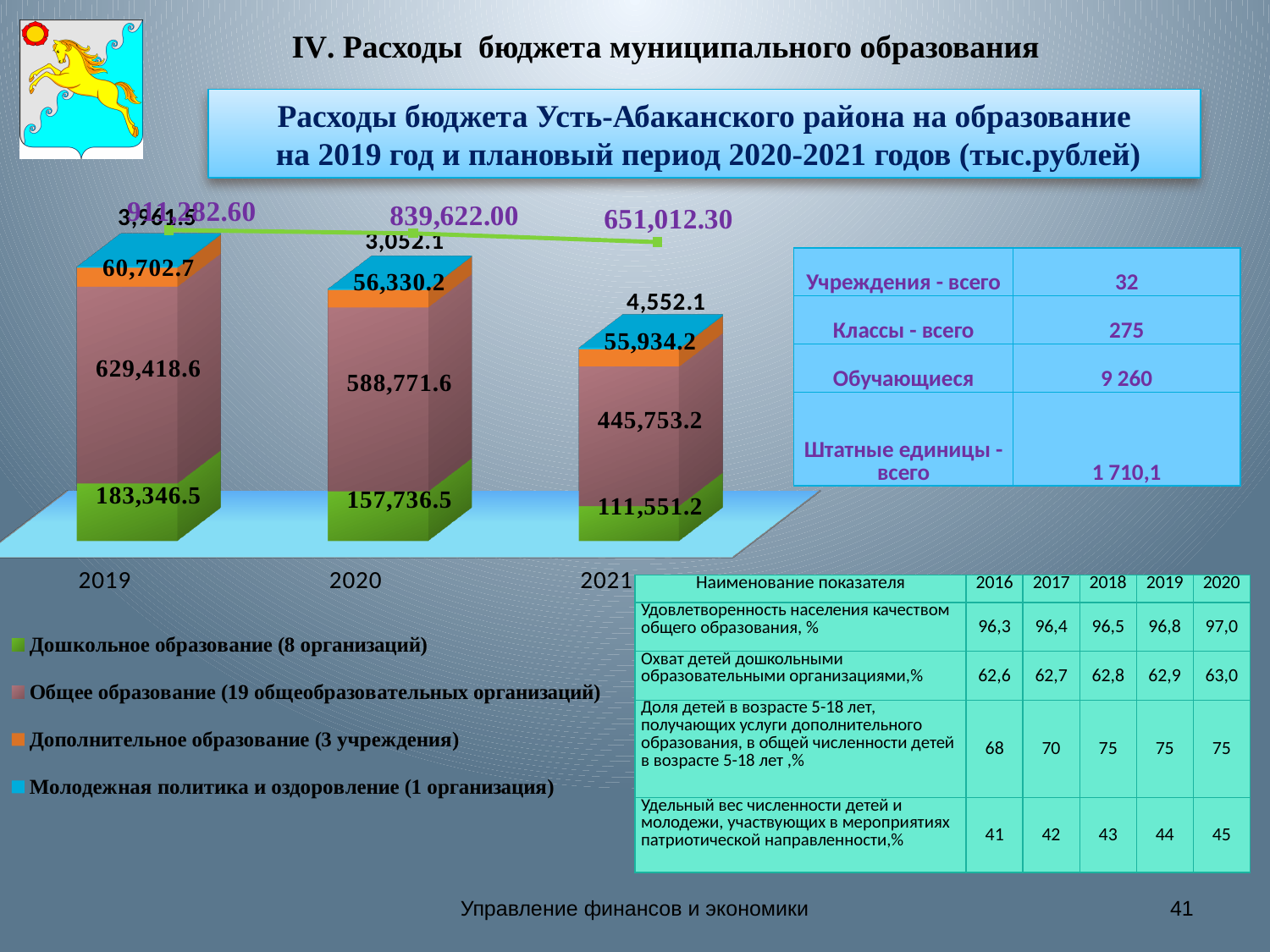
In which year is the value for Дошкольное образование the lowest? 2021 What is the value for Дошкольное образование in 2019? 183,346.5 What is the value for Дополнительное образование in 2020? 56,330.2 Does the value for Общее образование rise or fall from 2019 to 2021? fall What is the value for Молодежная политика и оздоровление in 2021? 4,552.1 What is the value for Общее образование in 2021? 445,753.2 How many series does the chart legend list? 4 How many years are shown on the x axis of the chart? 3 What is the difference between the Общее образование values for 2019 and 2020? 40,647.0 What value is printed on the line above the bars for 2020? 839,622.00 Which year has the larger value for Дополнительное образование, 2020 or 2021? 2020 In which year is the value for Общее образование the highest? 2019